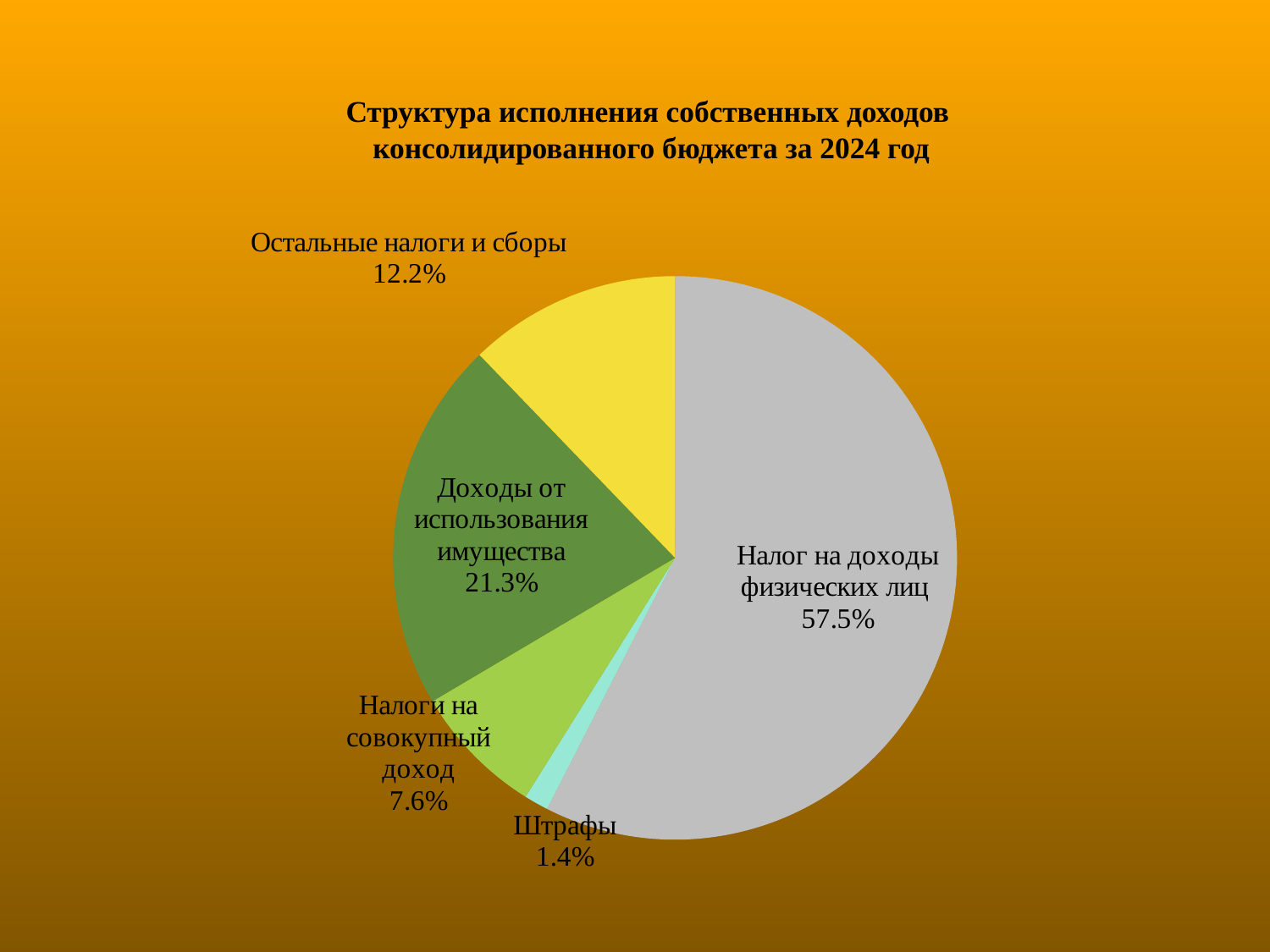
What is the title of the chart? Структура исполнения собственных доходов консолидированного бюджета за 2024 год What share of the pie does 'Налог на доходы физических лиц' have? 57.5% What type of chart is shown on the slide? pie chart What is the value shown for 'Штрафы'? 1.4% What is the difference in percentage points between 'Налог на доходы физических лиц' and 'Доходы от использования имущества'? 36.2 What is the value shown for 'Остальные налоги и сборы'? 12.2% Which category has the smallest slice of the pie? Штрафы Which category has the largest slice of the pie? Налог на доходы физических лиц What is the value shown for 'Доходы от использования имущества'? 21.3% How many slices does the pie chart have? 5 Which is larger: 'Остальные налоги и сборы' or 'Налоги на совокупный доход'? Остальные налоги и сборы What is the value shown for 'Налоги на совокупный доход'? 7.6%